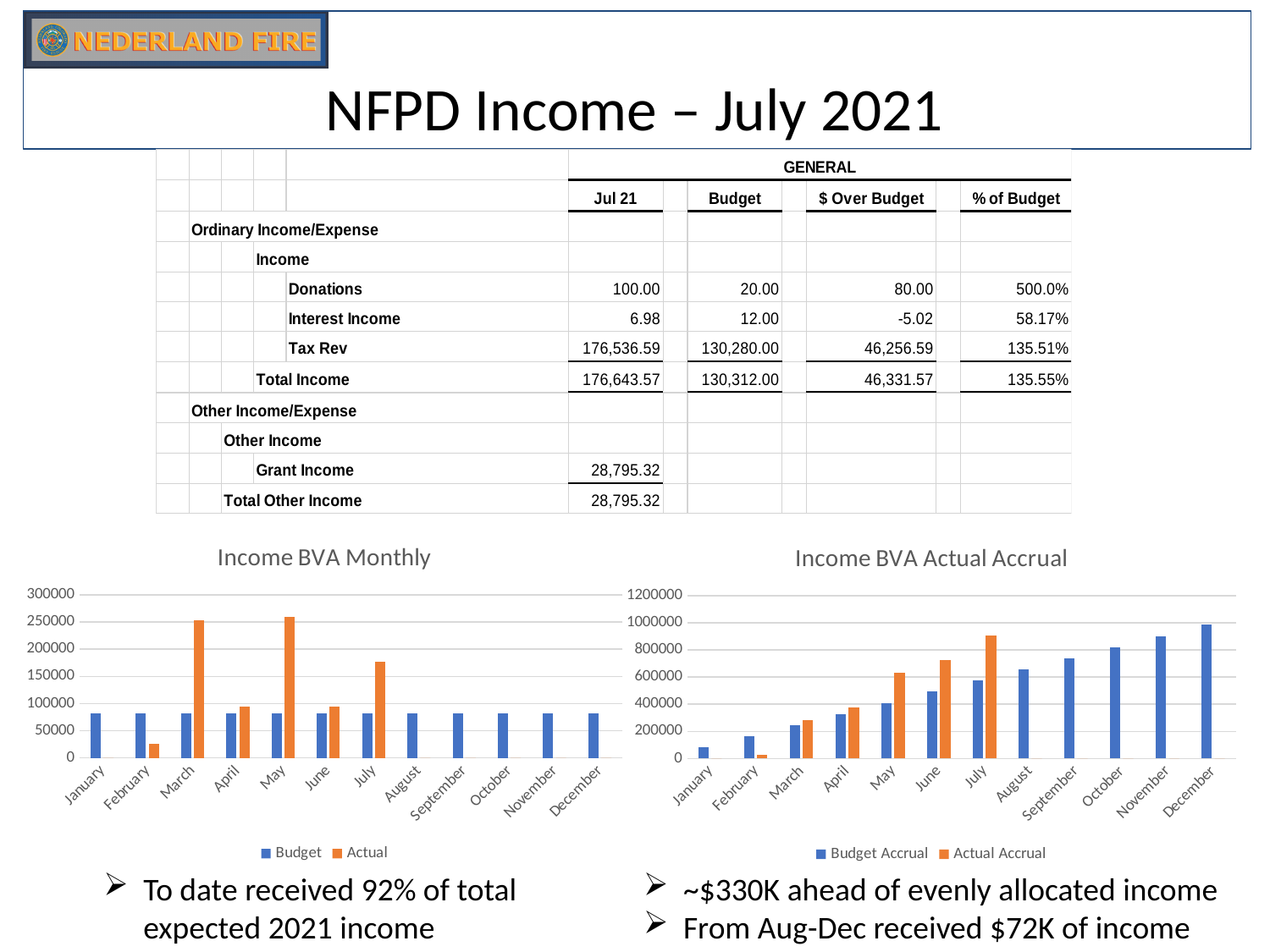
In the "Income BVA Monthly" chart, is the Actual value for July greater or less than 150000? greater How many months are shown on the x axis of the "Income BVA Monthly" chart? 12 In the "Income BVA Actual Accrual" chart, do the Budget Accrual values rise or fall from January to December? rise What kind of chart is the "Income BVA Monthly" chart? bar chart How many series does the legend of the "Income BVA Actual Accrual" chart list? 2 In the "Income BVA Actual Accrual" chart, which month has the highest Actual Accrual value? July In the "Income BVA Actual Accrual" chart, is the Actual Accrual or the Budget Accrual larger in July? Actual Accrual In the "Income BVA Monthly" chart, is the Actual value for March or for April larger? March In the "Income BVA Actual Accrual" chart, is the Budget Accrual value for December greater or less than 800000? greater In the "Income BVA Actual Accrual" chart, which month has the highest Budget Accrual value? December In the "Income BVA Monthly" chart, is the Actual value for February greater or less than 50000? less What are the two legend entries of the "Income BVA Monthly" chart? Budget and Actual